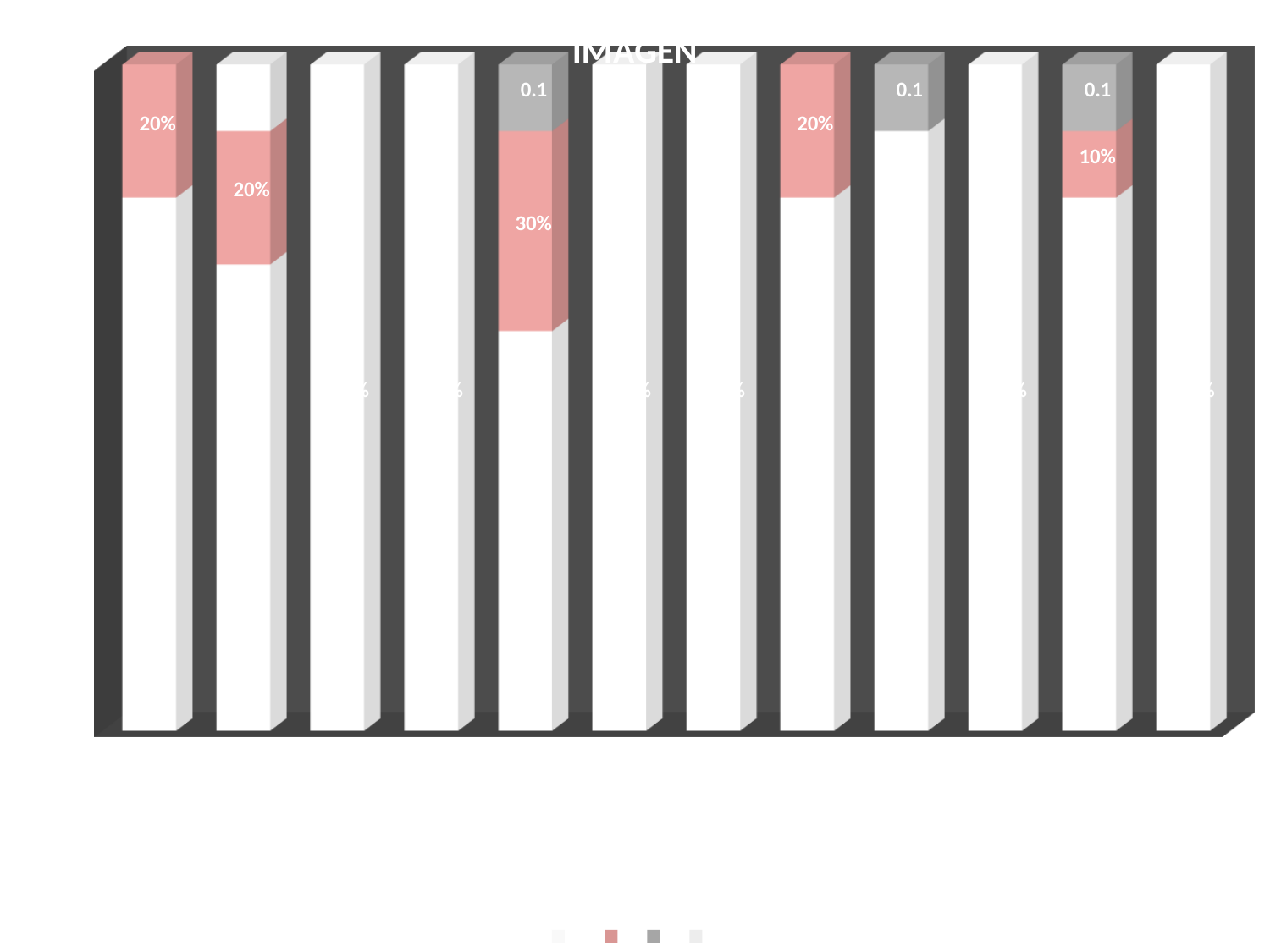
Which is larger, the pink segment of the fifth bar or the pink segment of the eleventh bar? the fifth bar What is the value printed on the pink segment of the fifth bar from the left? 30% How many bars have a pink segment with a printed label? 5 Which bar has the largest pink segment? the fifth bar from the left What is the value printed on the pink segment of the eleventh bar from the left? 10% How many series does the legend list? 4 What kind of chart is shown on the slide? bar chart What is the value printed on the gray segment of the ninth bar from the left? 0.1 What is the title of the chart? IMAGEN What is the difference between the pink segment of the fifth bar (30%) and the pink segment of the eleventh bar (10%)? 20% How many bars does the chart contain? 12 What is the value printed on the pink segment of the first bar from the left? 20%